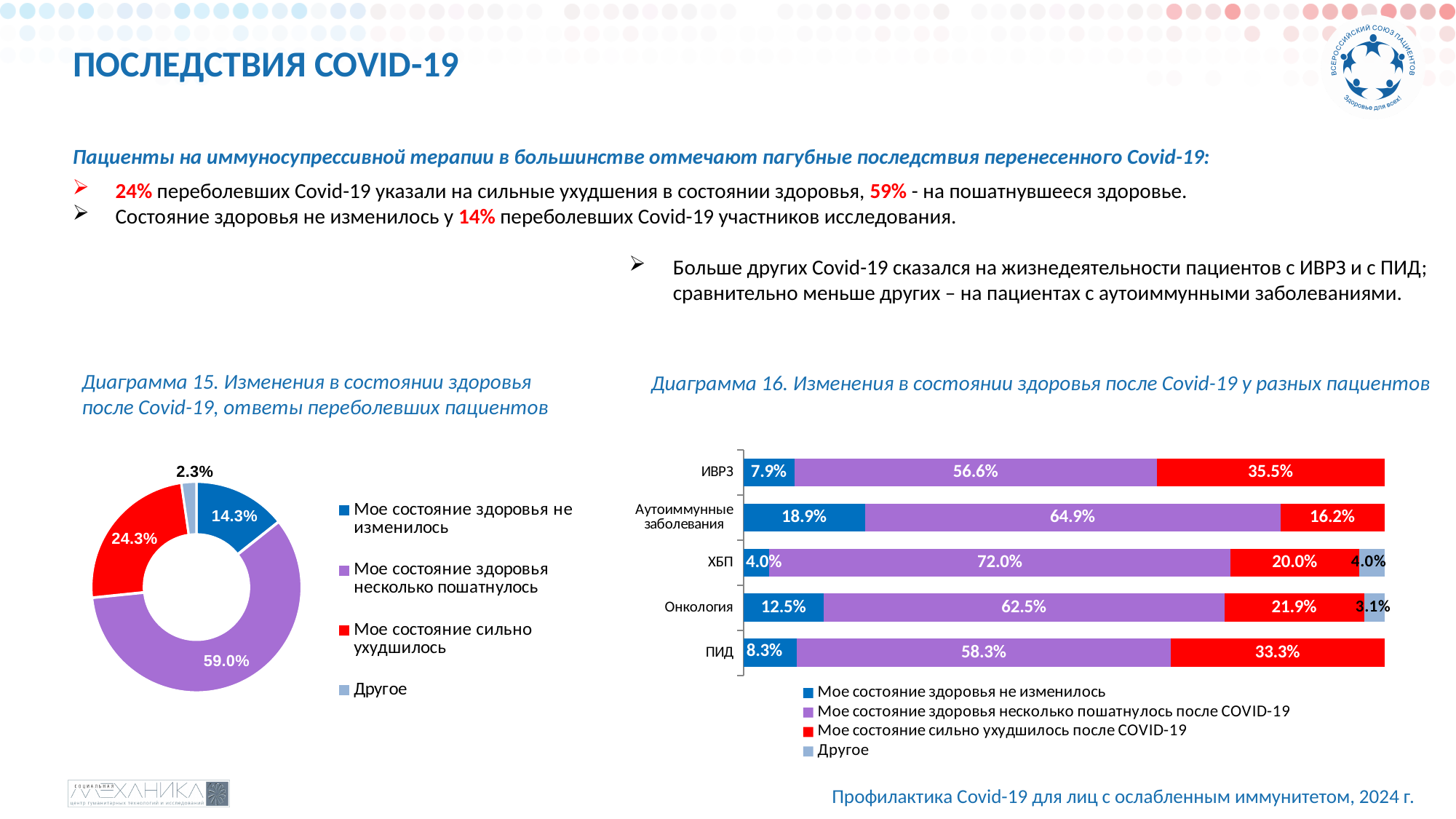
In Диаграмма 15, what share of respondents answered "Мое состояние здоровья не изменилось"? 14.3% In Диаграмма 15, which answer has the smallest share? Другое How many series does the legend of Диаграмма 16 list? 4 In Диаграмма 16, what is the difference between the "Мое состояние здоровья не изменилось" values for Онкология and ПИД? 4.2% How many patient groups are shown in Диаграмма 16? 5 In Диаграмма 15, which answer has the largest share? Мое состояние здоровья несколько пошатнулось In Диаграмма 16, which patient group has the highest value for "Мое состояние здоровья несколько пошатнулось после COVID-19"? ХБП What kind of chart is Диаграмма 15? Pie (donut) chart In Диаграмма 16, what is the value for "Мое состояние здоровья не изменилось" for Аутоиммунные заболевания? 18.9% In Диаграмма 16, which is larger: the "Мое состояние сильно ухудшилось после COVID-19" value for ПИД or for Онкология? ПИД In Диаграмма 15, what is the difference between the share for "Мое состояние здоровья несколько пошатнулось" and the share for "Мое состояние сильно ухудшилось"? 34.7% In Диаграмма 16, what is the value for "Мое состояние сильно ухудшилось после COVID-19" for ИВРЗ? 35.5%